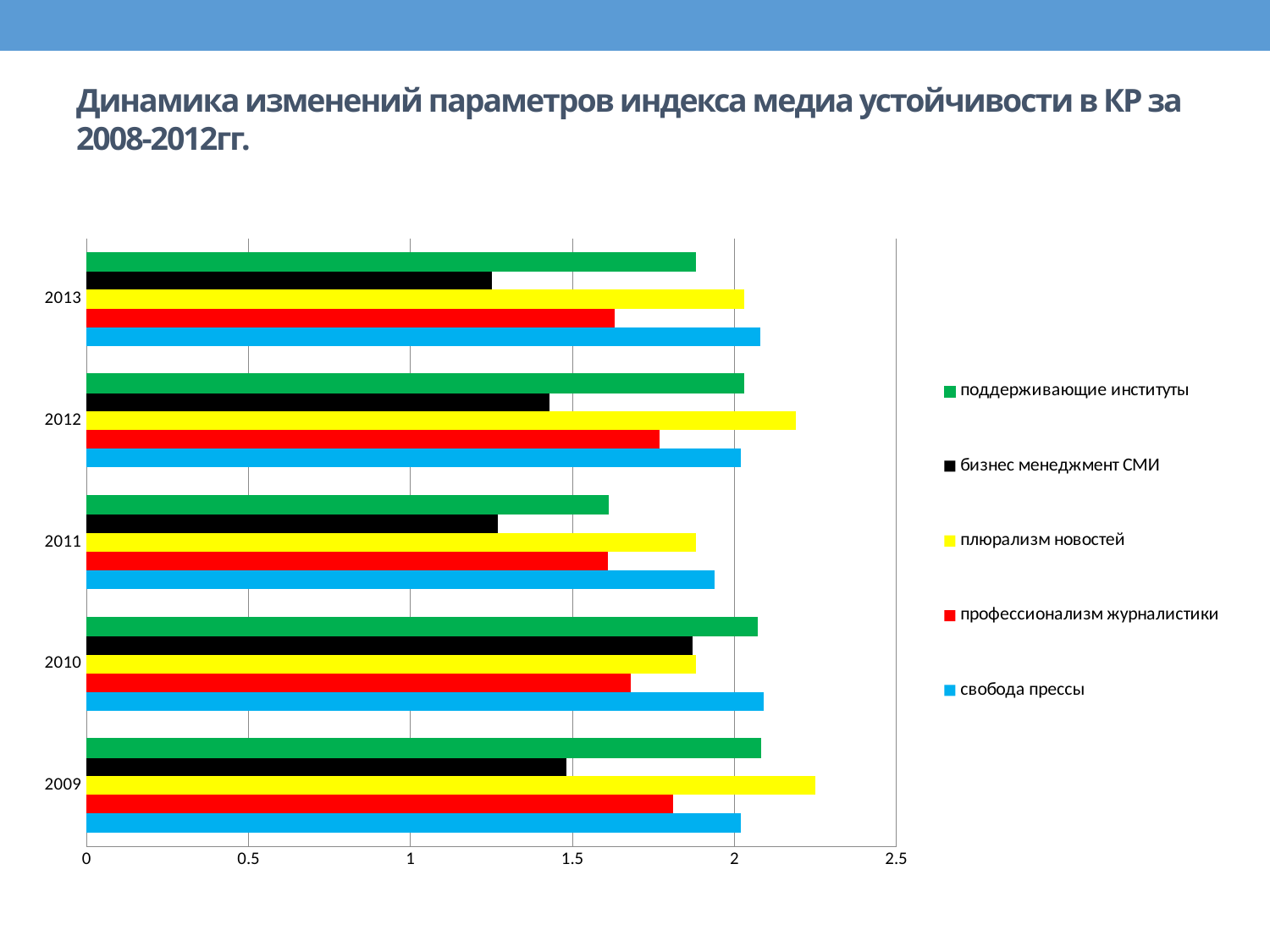
Which series has the lowest value in 2013? бизнес менеджмент СМИ Which series has the highest value in 2009? плюрализм новостей How many years are shown on the vertical axis of the chart? 5 Is the value for профессионализм журналистики in 2011 greater or less than 2? less What colour represents свобода прессы in the legend? blue Is the value for бизнес менеджмент СМИ in 2013 greater or less than 1.5? less Is the value for плюрализм новостей in 2009 greater or less than 2? greater What kind of chart is shown on the slide? bar chart In 2012, which is larger: плюрализм новостей or бизнес менеджмент СМИ? плюрализм новостей How many series does the legend list? 5 For бизнес менеджмент СМИ, which year has the larger value: 2010 or 2011? 2010